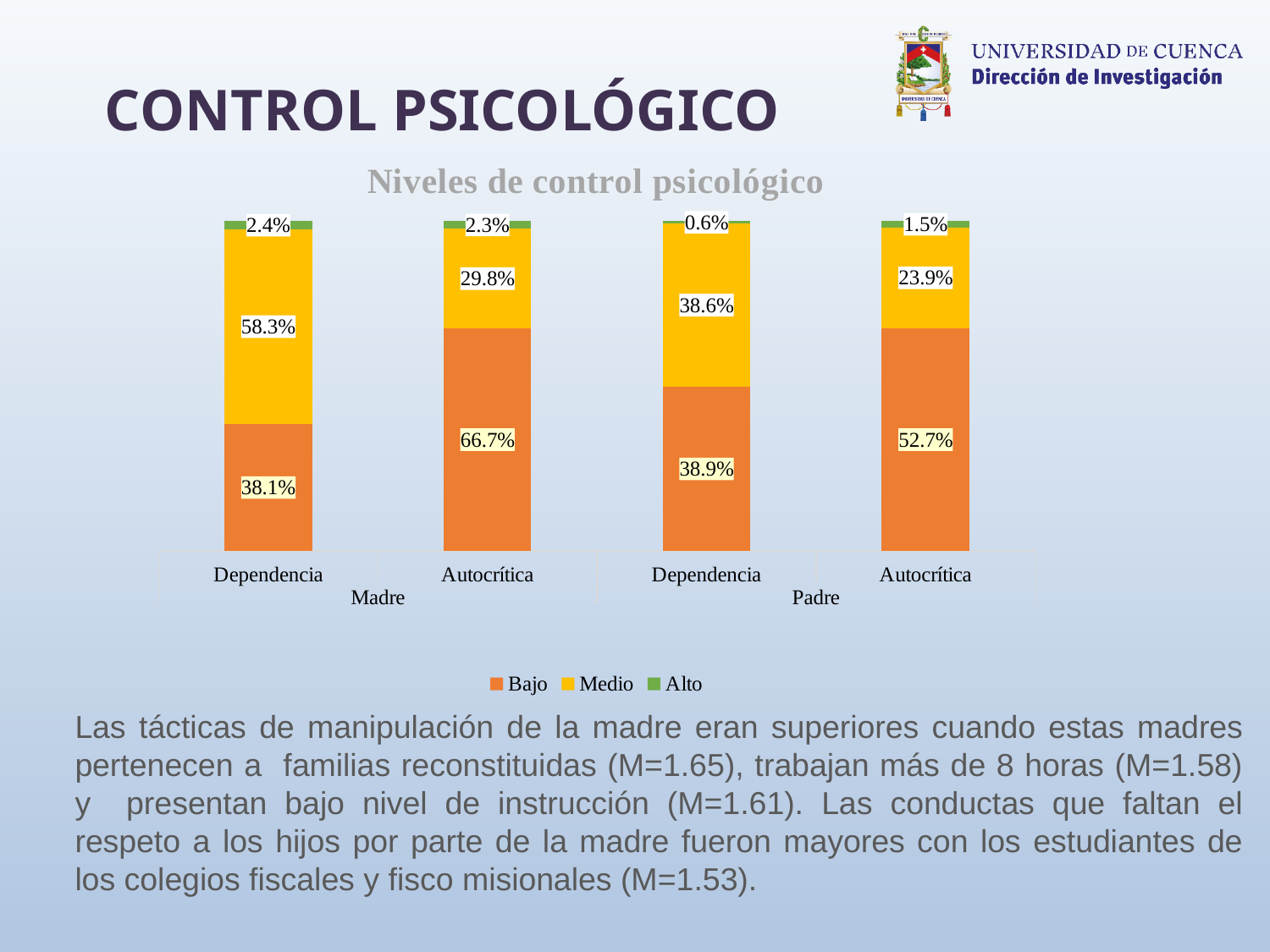
How many stacked bars are shown in the chart? 4 Which bar has the lowest Alto value? Dependencia (Padre) What is the Bajo value for Dependencia under Madre? 38.1% Which is larger: the Bajo value for Dependencia under Padre or the Bajo value for Autocrítica under Padre? Autocrítica (Padre) What is the difference between the Medio values for Dependencia and Autocrítica under Madre? 28.5% What is the Bajo value for Autocrítica under Madre? 66.7% What is the title of the chart? Niveles de control psicológico What is the Medio value for Autocrítica under Padre? 23.9% Which bar has the highest Bajo value? Autocrítica (Madre) How many series does the legend list? 3 What kind of chart is shown on the slide? Stacked bar chart What is the Alto value for Dependencia under Padre? 0.6%